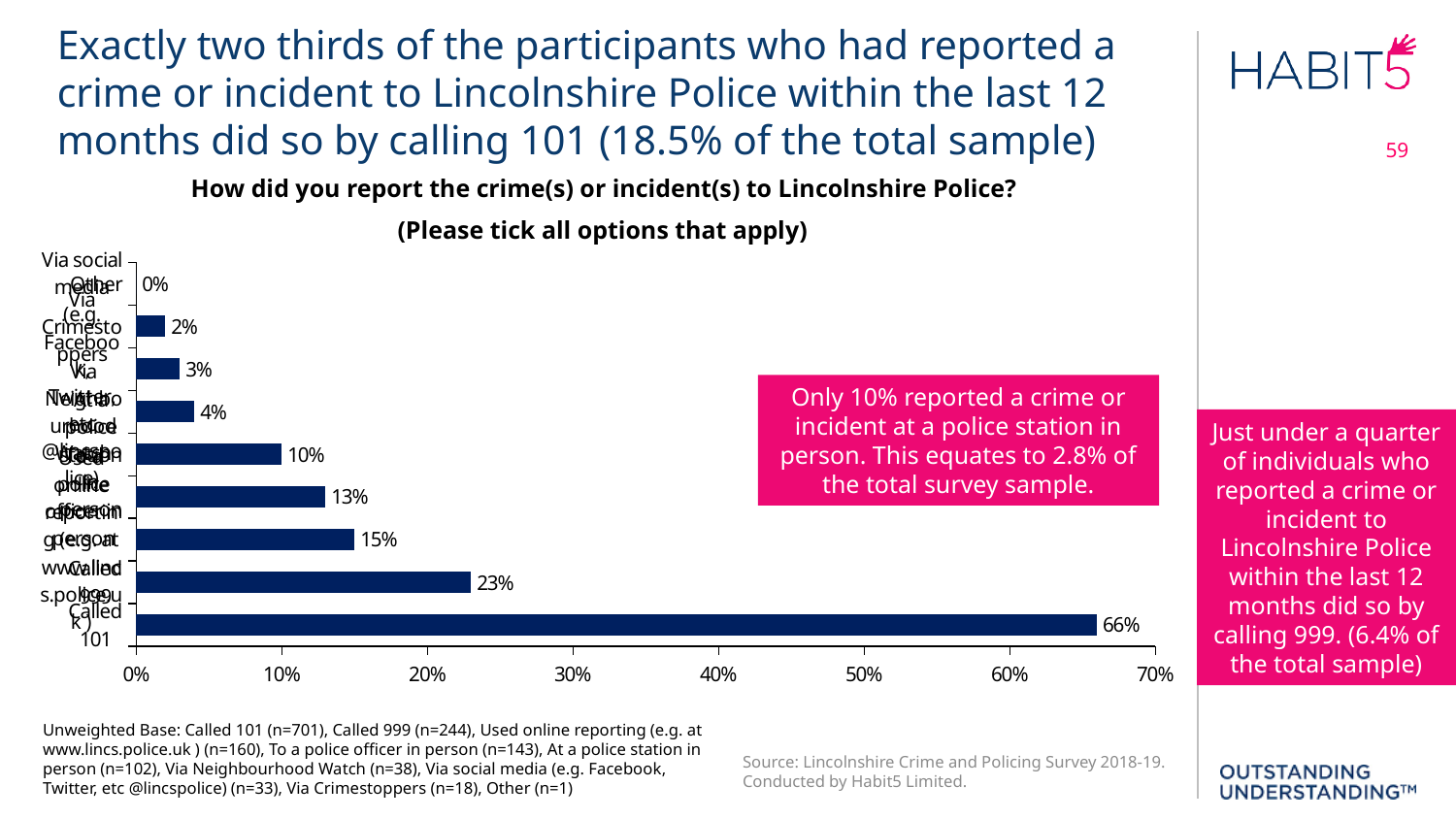
What type of chart is shown on the slide? Bar chart What percentage of participants reported a crime or incident at a police station in person? 10% What is the difference in percentage points between 'Called 101' and 'Called 999'? 43 percentage points Which is larger, the value for 'Called 101' or the value for 'Called 999'? Called 101 What percentage of participants reported the crime or incident by calling 999? 23% What percentage of participants reported the crime or incident by calling 101? 66% Is the value for 'Called 999' greater or less than 30%? less Is the value for 'Called 101' greater or less than 60%? greater What is the highest value shown on the chart's horizontal axis? 70% Which reporting method has the highest percentage in the chart? Called 101 How many bars (reporting methods) are shown in the chart? 9 What is the smallest data label value shown in the chart? 0%